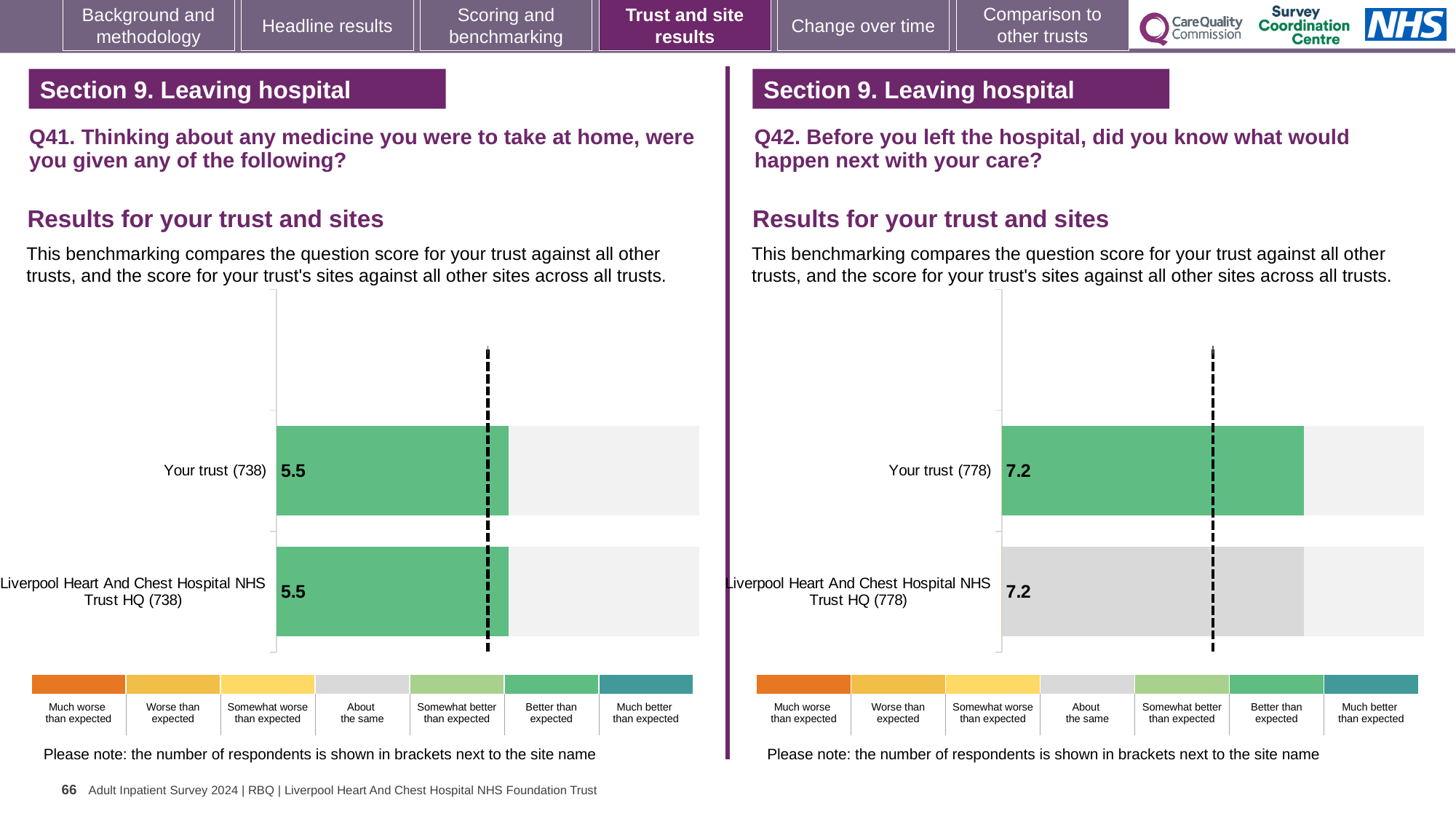
How many bars are plotted in the Q42 chart on the right? 2 In the Q41 chart on the left, what is the difference between the score for Your trust and the score for Liverpool Heart And Chest Hospital NHS Trust HQ? 0 In the Q41 chart on the left, what is the score for Liverpool Heart And Chest Hospital NHS Trust HQ? 5.5 In the Q41 chart on the left, what is the score for Your trust? 5.5 How many bars are plotted in the Q41 chart on the left? 2 In the Q42 chart on the right, what is the difference between the score for Your trust and the score for Liverpool Heart And Chest Hospital NHS Trust HQ? 0 In the Q42 chart on the right, which benchmark category does the grey colour of the Liverpool Heart And Chest Hospital NHS Trust HQ bar correspond to in the legend? About the same In the Q41 chart on the left, how many respondents are shown in brackets next to Your trust? 738 In the Q42 chart on the right, what is the score for Liverpool Heart And Chest Hospital NHS Trust HQ? 7.2 What kind of chart is the Q42 chart on the right? Bar chart In the Q42 chart on the right, what is the score for Your trust? 7.2 In the Q42 chart on the right, how many respondents are shown in brackets next to Liverpool Heart And Chest Hospital NHS Trust HQ? 778